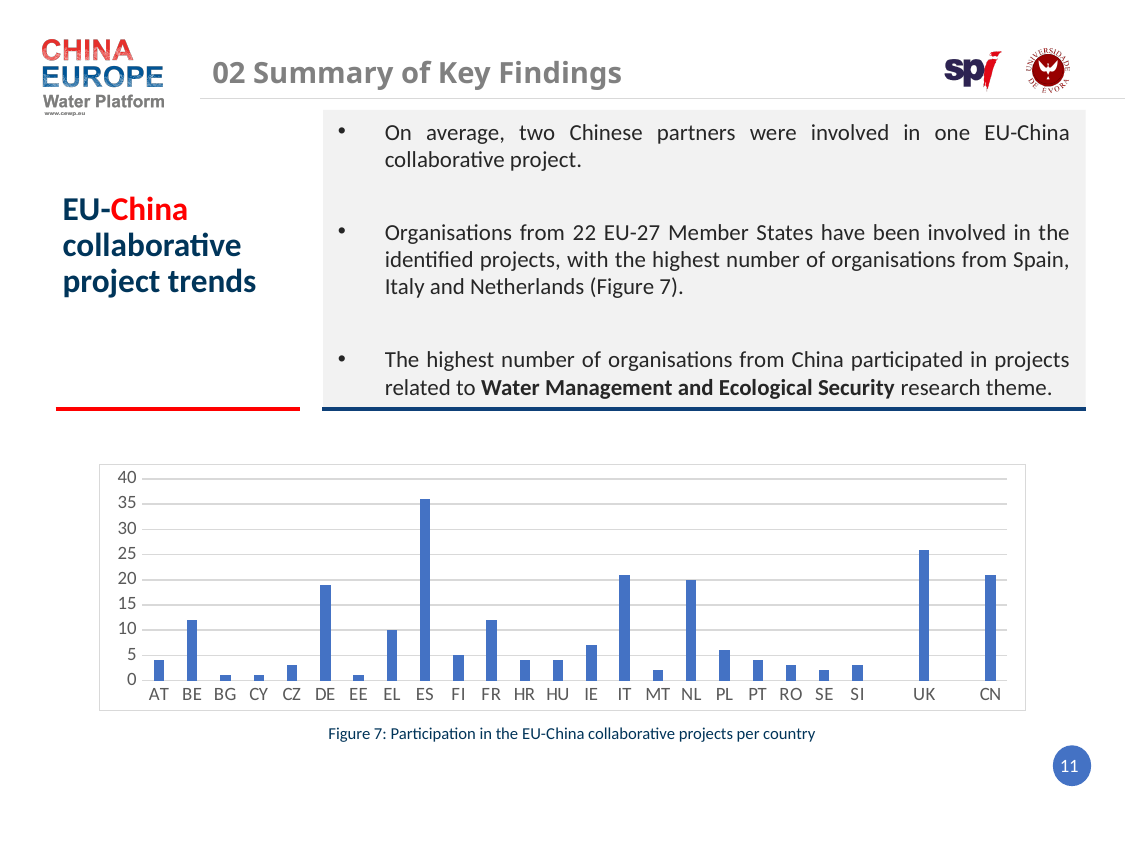
What is the caption of the chart? Figure 7: Participation in the EU-China collaborative projects per country Is the value for UK greater or less than 20? greater Is the value for ES greater or less than 30? greater How many countries are shown on the x axis of the chart? 24 Which has a larger value, IT or FR? IT Which has a larger value, ES or UK? ES Is the value for DE greater or less than 25? less Which has a larger value, DE or BE? DE Which country has the highest number of participating organisations in the chart? ES What kind of chart is shown in Figure 7? bar chart